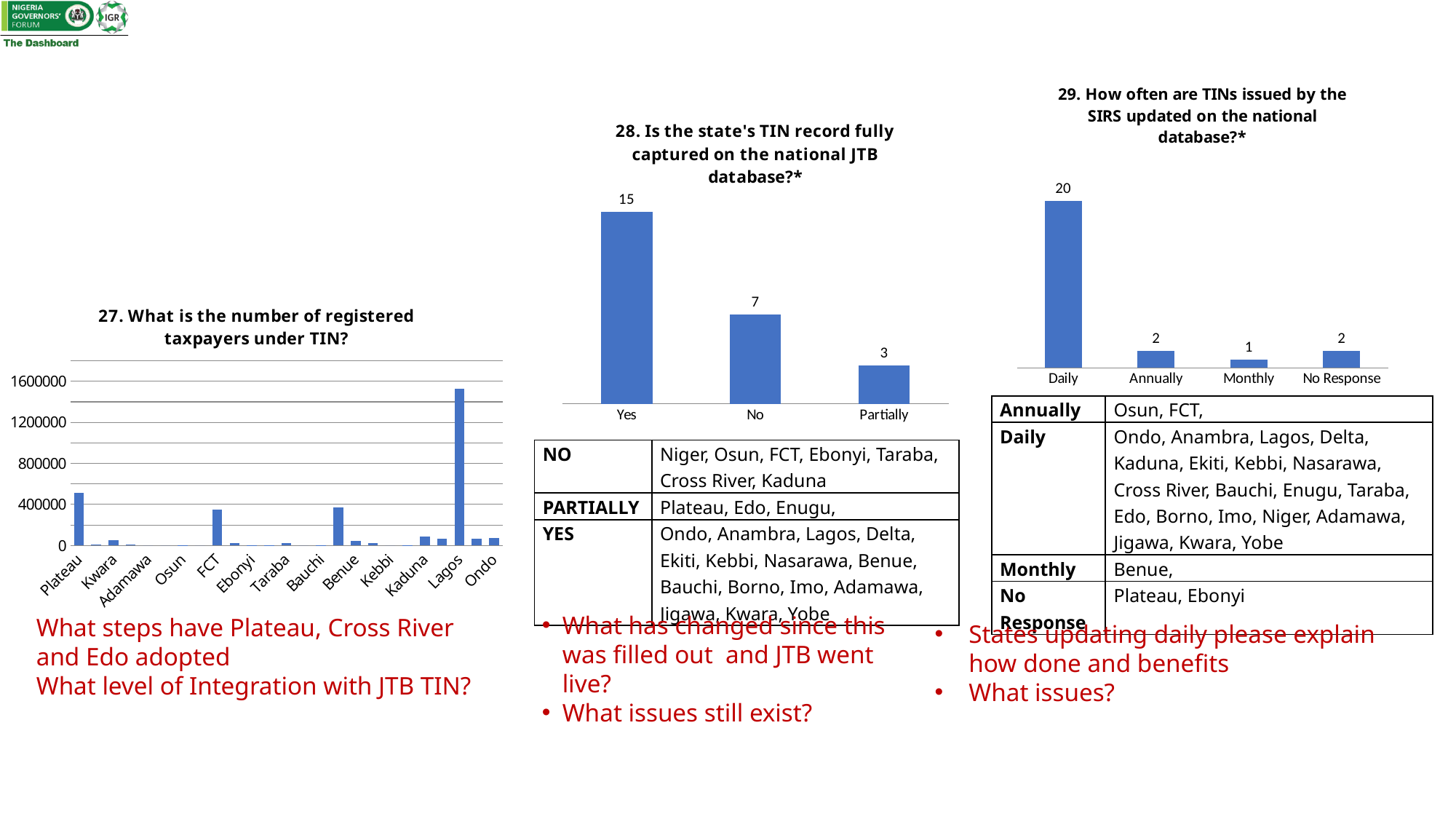
In the chart '29. How often are TINs issued by the SIRS updated on the national database?', what is the value for No Response? 2 In the chart '28. Is the state's TIN record fully captured on the national JTB database?', what is the value for Partially? 3 In the chart '28. Is the state's TIN record fully captured on the national JTB database?', how many categories are shown? 3 In the chart '29. How often are TINs issued by the SIRS updated on the national database?', which category has the lowest value? Monthly What kind of chart is '27. What is the number of registered taxpayers under TIN?'? bar chart In the chart '27. What is the number of registered taxpayers under TIN?', is the value for Lagos greater or less than 1200000? greater In the chart '28. Is the state's TIN record fully captured on the national JTB database?', what is the difference between Yes and No? 8 In the chart '29. How often are TINs issued by the SIRS updated on the national database?', how many categories are shown? 4 In the chart '27. What is the number of registered taxpayers under TIN?', which state has the highest value? Lagos In the chart '27. What is the number of registered taxpayers under TIN?', is the value for Plateau greater or less than 400000? greater In the chart '28. Is the state's TIN record fully captured on the national JTB database?', what is the value for Yes? 15 In the chart '29. How often are TINs issued by the SIRS updated on the national database?', what is the value for Daily? 20